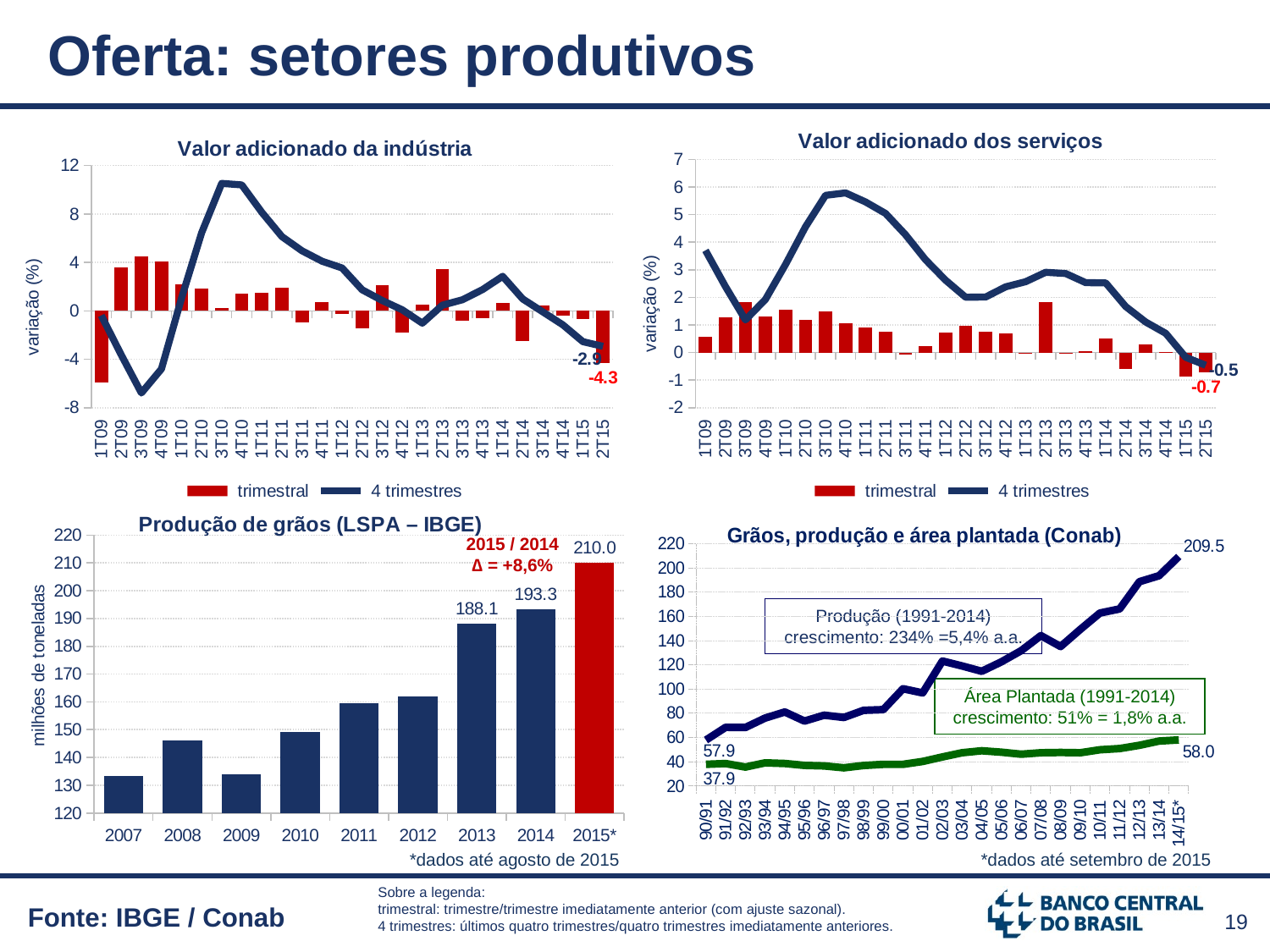
In the 'Produção de grãos (LSPA – IBGE)' chart, what is the value for 2014? 193.3 In the 'Grãos, produção e área plantada (Conab)' chart, does the production line rise or fall from 90/91 to 14/15*? rise In the 'Grãos, produção e área plantada (Conab)' chart, what is the production value labelled for 14/15*? 209.5 In the 'Produção de grãos (LSPA – IBGE)' chart, is the value for 2011 greater or less than 150? greater In the 'Valor adicionado da indústria' chart, what is the labelled value of the trimestral bar for 2T15? -4.3 In the 'Produção de grãos (LSPA – IBGE)' chart, what is the difference between the 2015* and 2014 values? 16.7 In the 'Produção de grãos (LSPA – IBGE)' chart, what is the value for 2015*? 210.0 How many bars are plotted in the 'Produção de grãos (LSPA – IBGE)' chart? 9 In the 'Produção de grãos (LSPA – IBGE)' chart, which year has the highest value? 2015* In the 'Grãos, produção e área plantada (Conab)' chart, what is the planted area value labelled for 90/91? 37.9 What kind of chart is 'Produção de grãos (LSPA – IBGE)'? bar chart How many series does the legend of the 'Valor adicionado dos serviços' chart list? 2